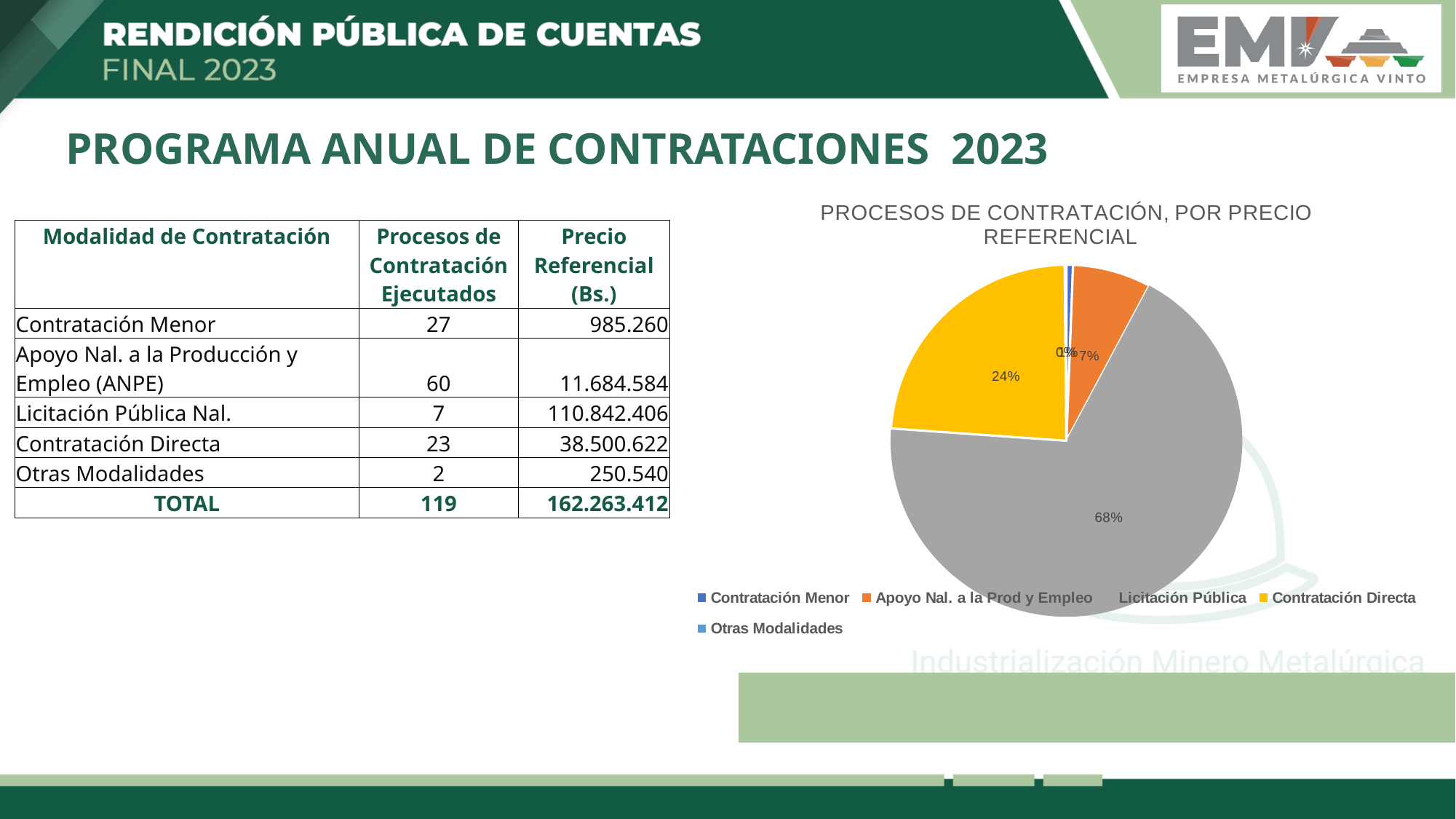
What kind of chart is shown on the slide? pie chart How many categories does the pie chart legend list? 5 How many percentage points larger is the Contratación Directa slice than the Apoyo Nal. a la Prod y Empleo slice? 17 percentage points Which slice is larger, Contratación Directa or Apoyo Nal. a la Prod y Empleo? Contratación Directa Which category has the largest slice of the pie? Licitación Pública What is the title of the pie chart? PROCESOS DE CONTRATACIÓN, POR PRECIO REFERENCIAL What share of the pie does Contratación Directa represent? 24% What share of the pie does Apoyo Nal. a la Prod y Empleo represent? 7% Does the Licitación Pública slice account for more or less than half of the pie? more How many percentage points larger is the Licitación Pública slice than the Contratación Directa slice? 44 percentage points What colour is the Contratación Directa slice in the pie chart? yellow What share of the pie does Licitación Pública represent? 68%